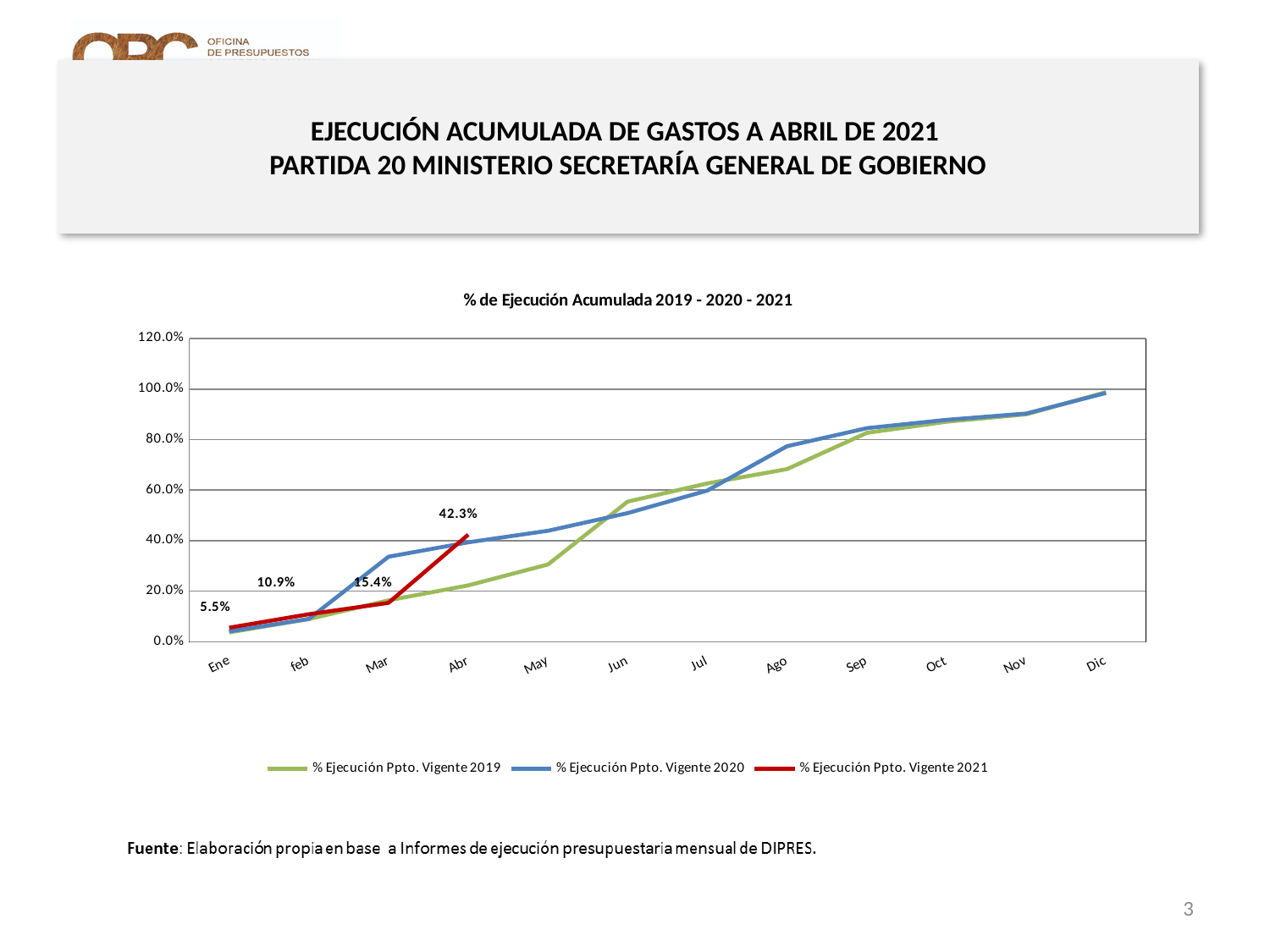
What is the difference between the 2021 values for Abr and Mar? 26.9 percentage points What is the value of % Ejecución Ppto. Vigente 2021 in Mar? 15.4% What is the value of % Ejecución Ppto. Vigente 2021 in Abr? 42.3% Which month has the highest labelled value for % Ejecución Ppto. Vigente 2021? Abr In Mar, which series is larger: % Ejecución Ppto. Vigente 2019 or % Ejecución Ppto. Vigente 2020? % Ejecución Ppto. Vigente 2020 Is the value for % Ejecución Ppto. Vigente 2020 in Ago greater or less than 60%? greater Does the % Ejecución Ppto. Vigente 2021 line rise or fall from Ene to Abr? Rise How many series does the legend list? 3 How many months are shown on the x axis? 12 What kind of chart is shown on the slide? Line chart What is the value of % Ejecución Ppto. Vigente 2021 in Ene? 5.5% What colour is the line for % Ejecución Ppto. Vigente 2021? Red